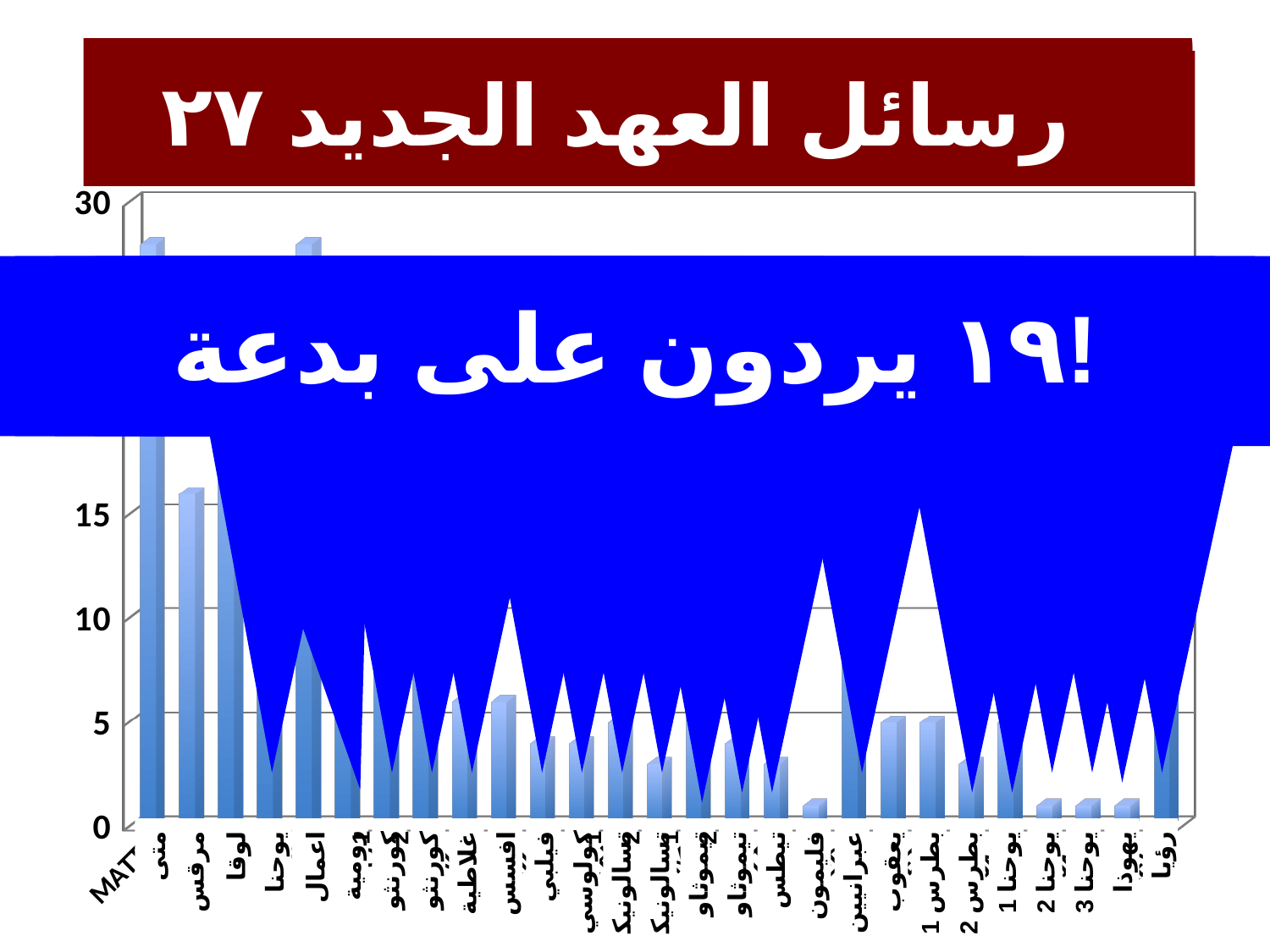
What kind of chart is shown on the slide? bar chart Is the value for يعقوب greater or less than 10? less Is the value for متى greater or less than 15? greater Which has the larger value, مرقس or فليمون? مرقس What is the highest value shown on the y axis of the chart? 30 Is the value for مرقس greater or less than 10? greater Which has the larger value, متى or مرقس? متى How many categories (books) are shown along the x axis of the chart? 27 What is the title of the chart on the slide? رسائل العهد الجديد ٢٧